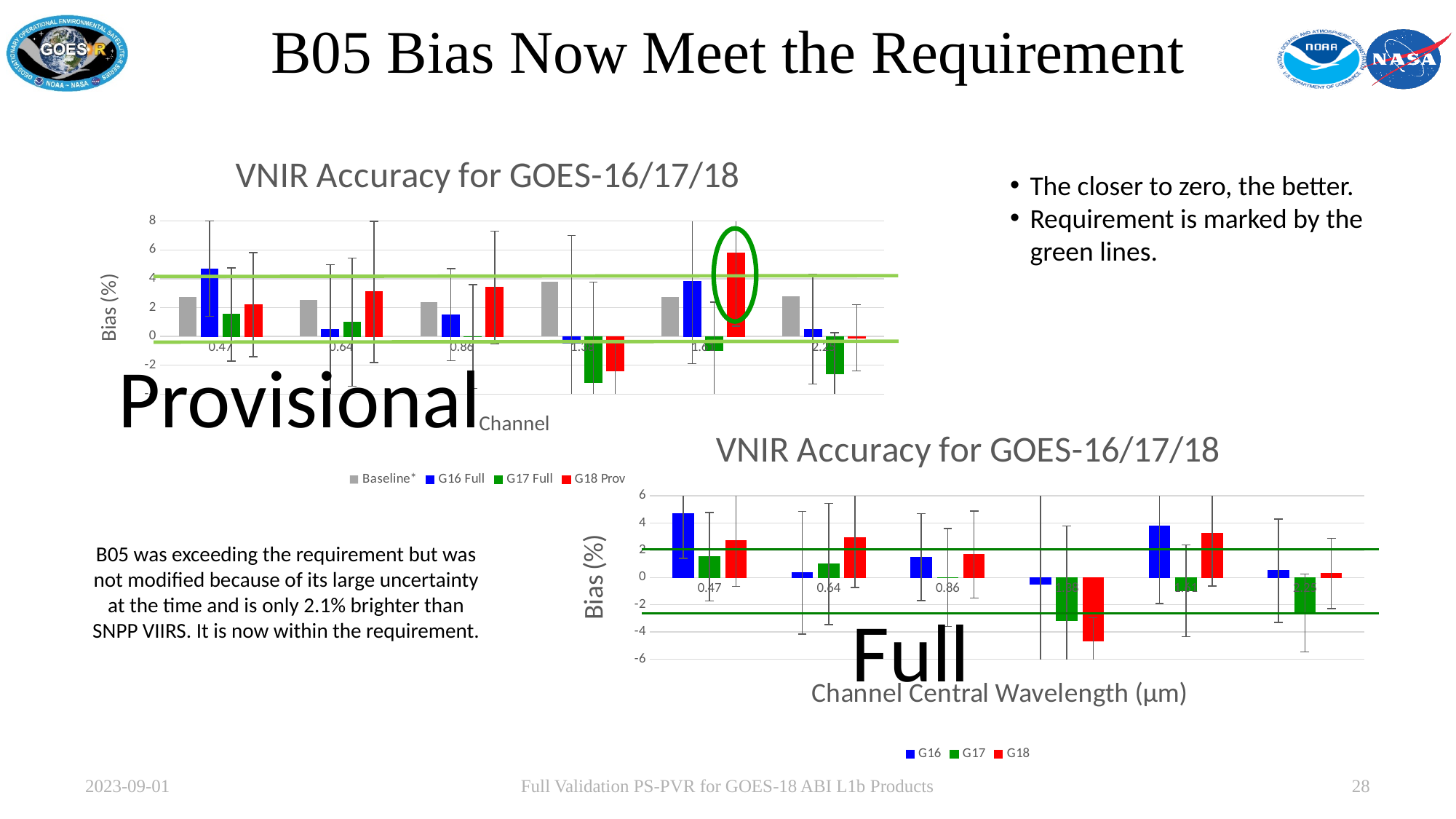
How many series does the legend of the top-left 'Provisional' chart list? 4 In the top-left 'Provisional' chart, which series is shown in grey? Baseline* In the top-left 'Provisional' chart, is the G17 Full value at 0.47 greater or less than 2? less What is the title of the bottom-right 'Full' chart? VNIR Accuracy for GOES-16/17/18 In the top-left 'Provisional' chart, is the G16 Full value at 0.47 greater or less than 4? greater In the bottom-right 'Full' chart, is the G18 value at 0.64 greater or less than 2? greater How many series does the legend of the bottom-right 'Full' chart list? 3 What type of chart is the top-left chart labelled 'Provisional'? bar chart In the bottom-right 'Full' chart, at 0.47, which is larger: G16 or G18? G16 In the top-left 'Provisional' chart, at 0.47, which is larger: G16 Full or G17 Full? G16 Full